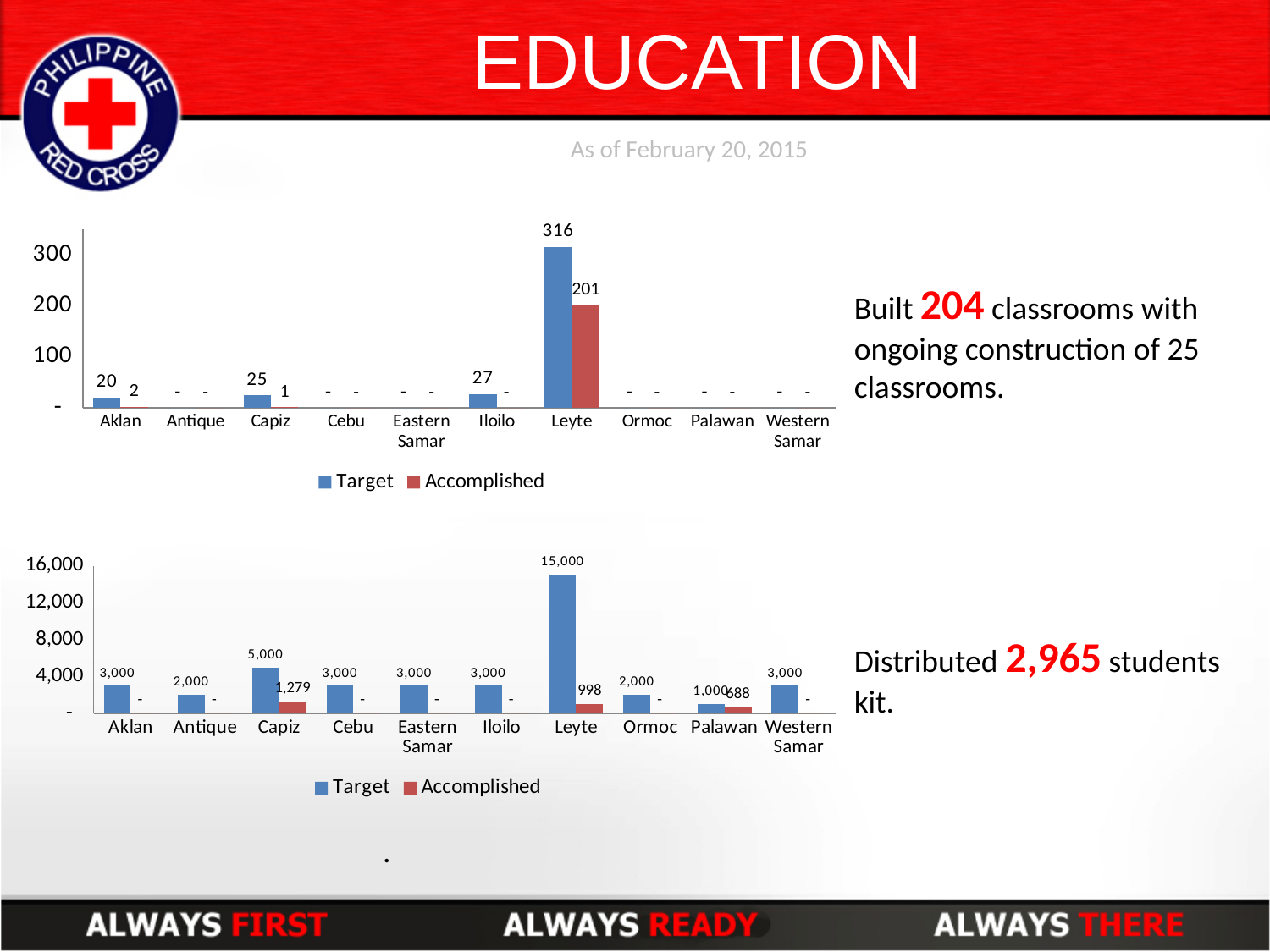
What kind of chart is the bottom chart? Bar chart In the top chart, what is the Accomplished value for Leyte? 201 In the bottom chart, what is the Accomplished value for Leyte? 998 In the top chart, what is the difference between the Target and Accomplished values for Leyte? 115 In the bottom chart, what is the Target value for Capiz? 5,000 In the bottom chart, what is the Accomplished value for Palawan? 688 In the top chart, what is the Target value for Leyte? 316 In the top chart, which category has the highest Target value? Leyte In the top chart, what is the Target value for Iloilo? 27 In the bottom chart, how many categories are shown on the x axis? 10 In the top chart, how many series does the legend list? 2 In the bottom chart, which is larger, the Accomplished value for Capiz or the Accomplished value for Leyte? Capiz